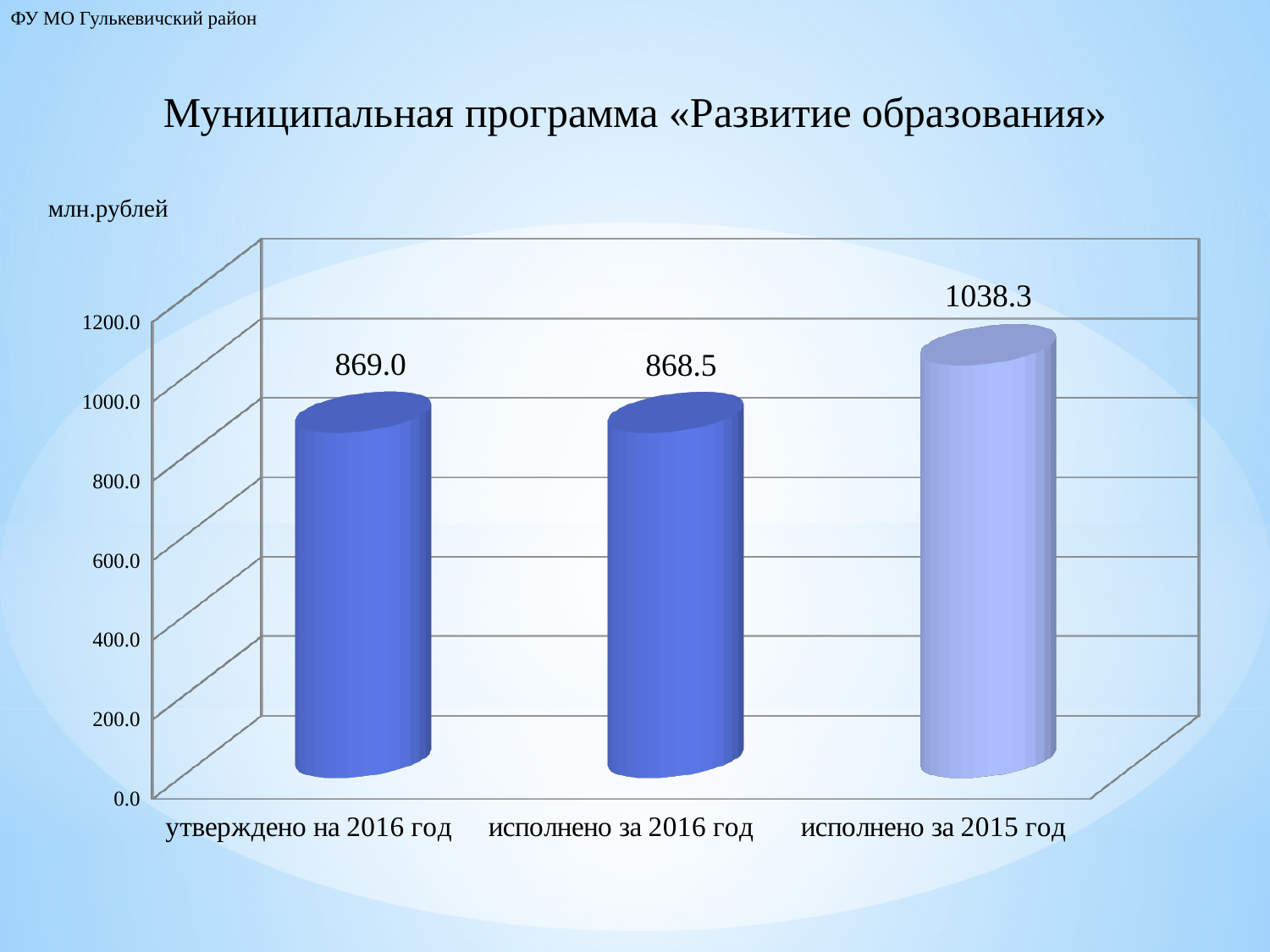
What is the value for «исполнено за 2015 год»? 1038.3 Is the value for «утверждено на 2016 год» greater or less than 1000.0? less What is the value for «утверждено на 2016 год»? 869.0 What unit of measurement is indicated above the chart? млн.рублей What is the difference between the values for «исполнено за 2015 год» and «утверждено на 2016 год»? 169.3 Is the value for «исполнено за 2015 год» greater or less than 1000.0? greater How many categories are shown on the chart? 3 Which category has the highest value? исполнено за 2015 год What is the difference between the values for «исполнено за 2015 год» and «исполнено за 2016 год»? 169.8 What kind of chart is shown on the slide? bar chart Which is larger: the value for «исполнено за 2015 год» or the value for «утверждено на 2016 год»? исполнено за 2015 год What is the value for «исполнено за 2016 год»? 868.5